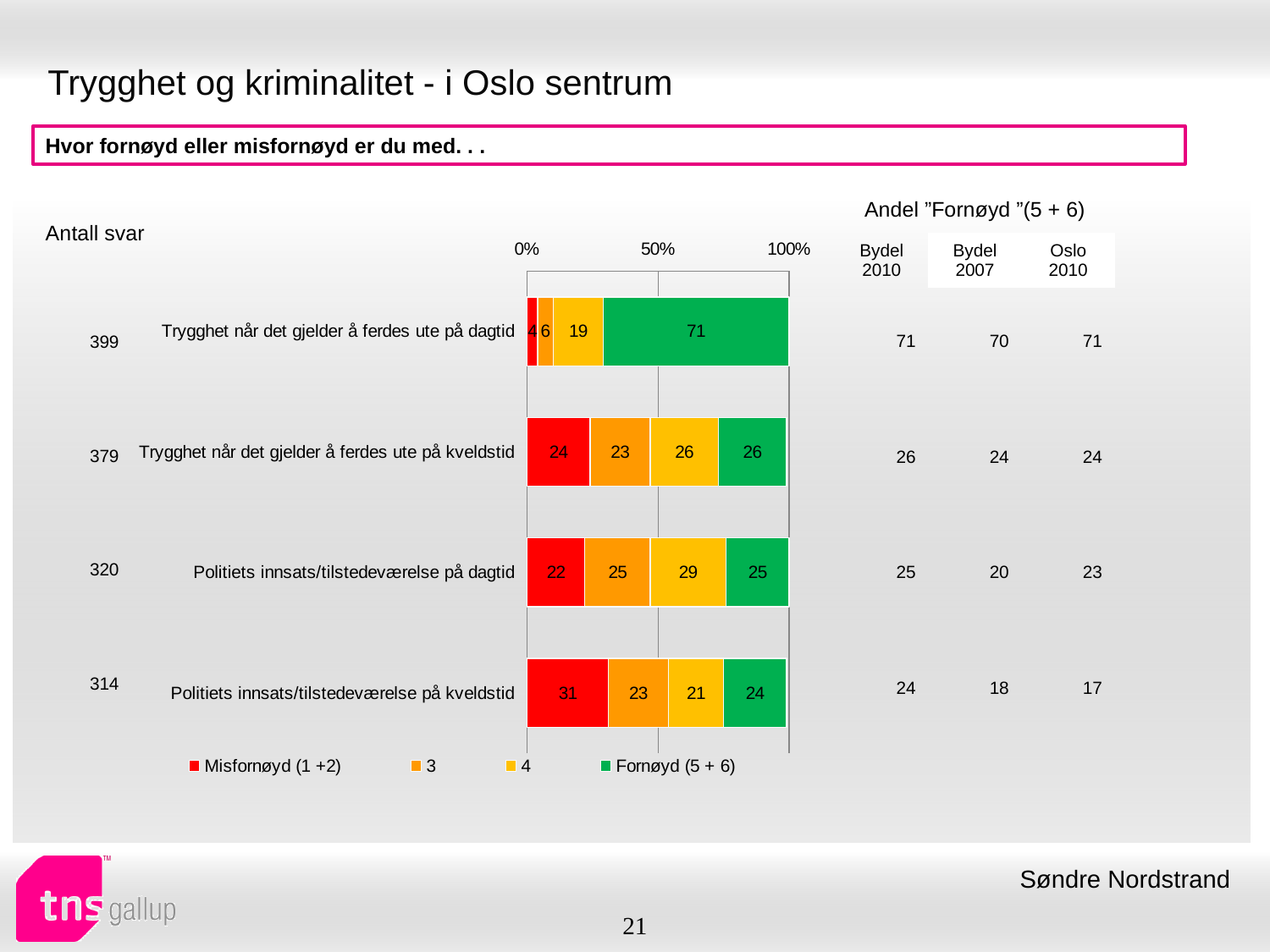
What is the value of the "4" segment for "Politiets innsats/tilstedeværelse på dagtid"? 29 How many categories are shown in the bar chart? 4 What is the value of the "Misfornøyd (1 +2)" segment for "Politiets innsats/tilstedeværelse på kveldstid"? 31 How many series does the legend list? 4 What is the value of the "3" segment for "Trygghet når det gjelder å ferdes ute på kveldstid"? 23 What is the difference between the "Misfornøyd (1 +2)" values for "Politiets innsats/tilstedeværelse på kveldstid" and "Politiets innsats/tilstedeværelse på dagtid"? 9 Which category has the lowest "Misfornøyd (1 +2)" value? Trygghet når det gjelder å ferdes ute på dagtid Which category has the highest "Fornøyd (5 + 6)" value? Trygghet når det gjelder å ferdes ute på dagtid What is the total of the stacked bar for "Politiets innsats/tilstedeværelse på kveldstid"? 99 What is the value of the "Fornøyd (5 + 6)" segment for "Trygghet når det gjelder å ferdes ute på dagtid"? 71 Which is larger: the "Fornøyd (5 + 6)" value for "Trygghet når det gjelder å ferdes ute på kveldstid" or for "Politiets innsats/tilstedeværelse på kveldstid"? Trygghet når det gjelder å ferdes ute på kveldstid What kind of chart is shown on the slide? Stacked bar chart